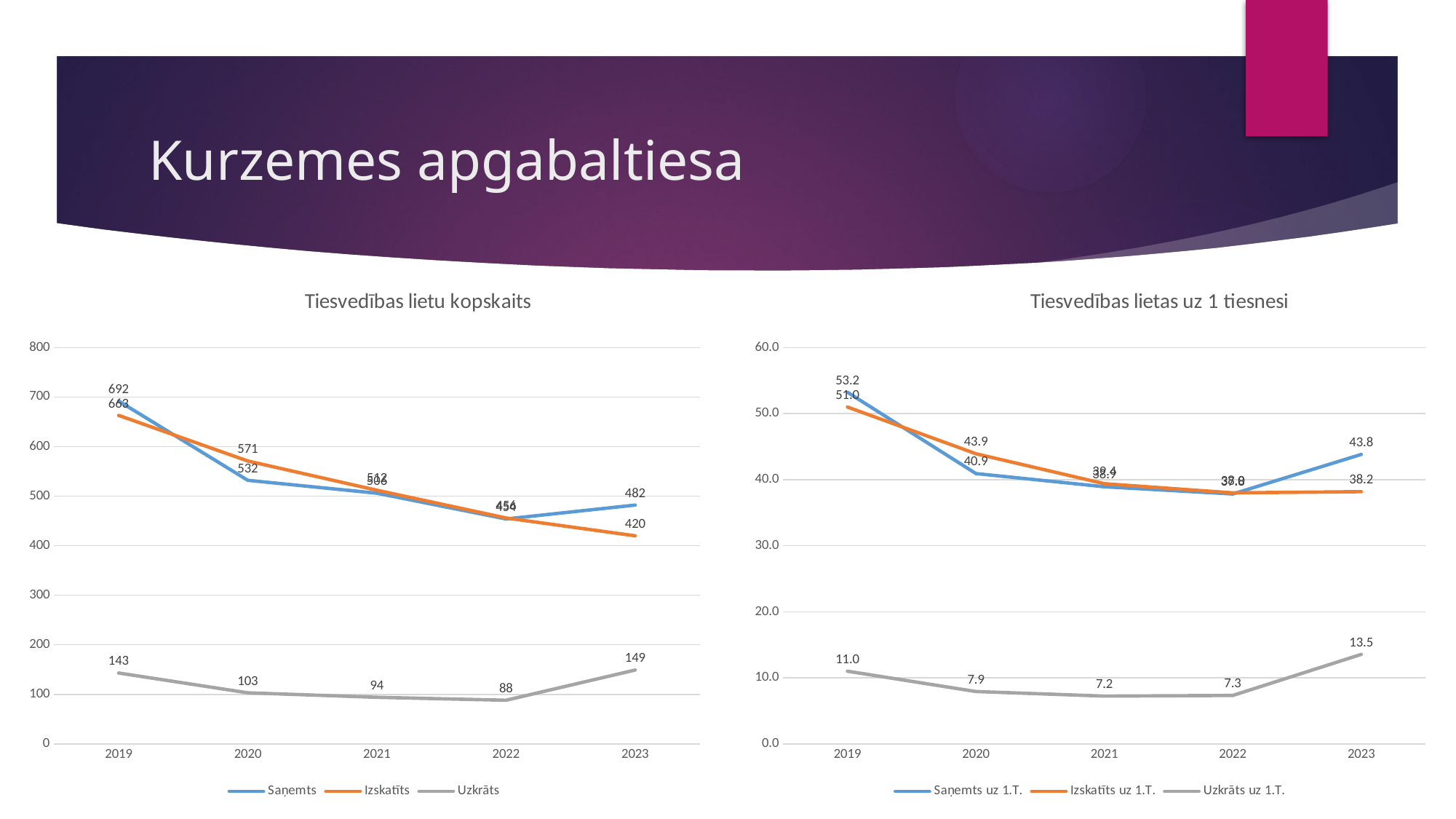
In the 'Tiesvedības lietas uz 1 tiesnesi' chart, which is larger in 2020: Saņemts uz 1.T. or Izskatīts uz 1.T.? Izskatīts uz 1.T. In the 'Tiesvedības lietas uz 1 tiesnesi' chart, what is the Saņemts uz 1.T. value for 2020? 40.9 In the 'Tiesvedības lietu kopskaits' chart, what is the difference between the Uzkrāts values for 2023 and 2022? 61 In the 'Tiesvedības lietu kopskaits' chart, what is the Izskatīts value for 2023? 420 In the 'Tiesvedības lietu kopskaits' chart, in which year is the Uzkrāts value lowest? 2022 What kind of chart is the 'Tiesvedības lietu kopskaits' chart? line chart How many years are shown on the x axis of the 'Tiesvedības lietas uz 1 tiesnesi' chart? 5 How many series does the legend of the 'Tiesvedības lietu kopskaits' chart list? 3 In the 'Tiesvedības lietu kopskaits' chart, what is the Uzkrāts value for 2023? 149 In the 'Tiesvedības lietas uz 1 tiesnesi' chart, what is the Uzkrāts uz 1.T. value for 2023? 13.5 In the 'Tiesvedības lietu kopskaits' chart, does the Izskatīts line rise or fall from 2019 to 2023? fall In the 'Tiesvedības lietu kopskaits' chart, what is the Saņemts value for 2019? 692